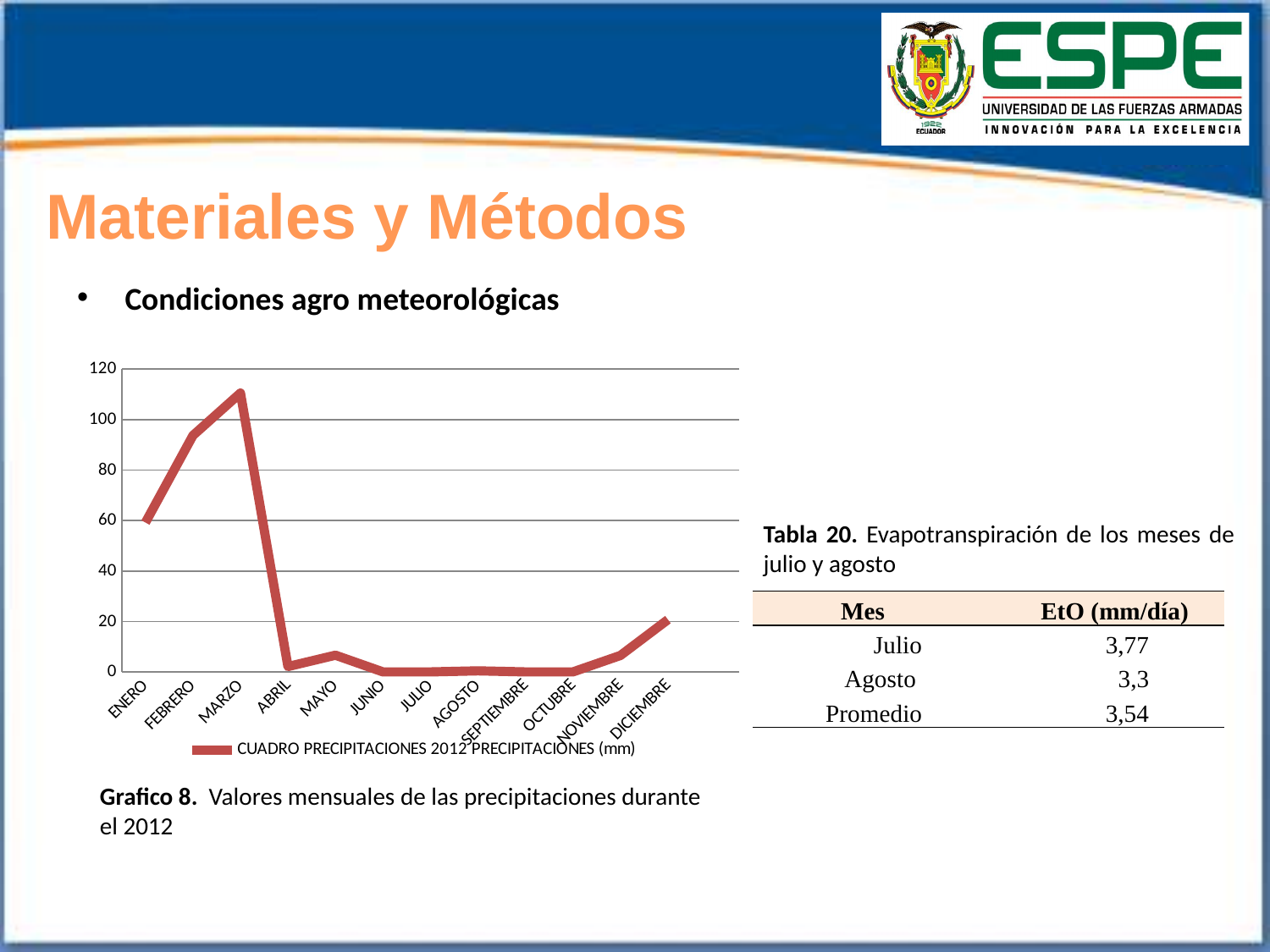
Is the precipitation value for ABRIL greater or less than 20? less How many months are plotted along the x axis of the chart? 12 Which month has the larger precipitation value, FEBRERO or ABRIL? FEBRERO Is the precipitation value for MARZO greater or less than 100? greater How many series does the chart legend list? 1 Is the precipitation value for ENERO greater or less than 40? greater What is the legend entry shown below the chart? CUADRO PRECIPITACIONES 2012 PRECIPITACIONES (mm) Do the precipitation values rise or fall from MARZO to ABRIL? fall Do the precipitation values rise or fall from ENERO to MARZO? rise Which month has the highest precipitation value in the chart? MARZO What kind of chart is shown on the slide? line chart